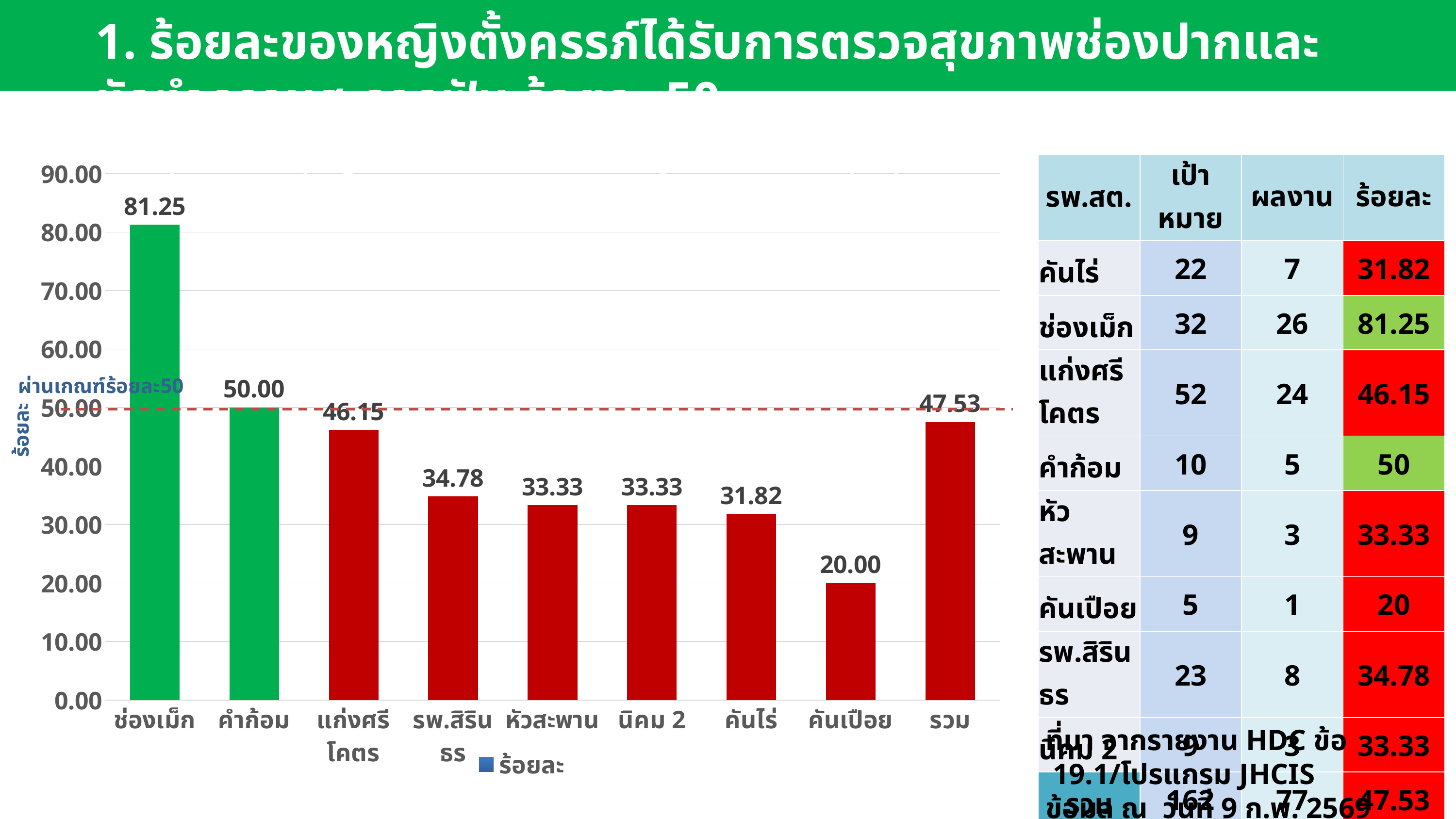
Which category has the highest value? ช่องเม็ก What is the difference between the values for ช่องเม็ก and คำก้อม? 31.25 Which is larger, the value for รพ.สิรินธร or the value for คันไร่? รพ.สิรินธร What is the value for แก่งศรีโคตร? 46.15 What is the legend entry for the plotted series? ร้อยละ What is the value for คันเปือย? 20.00 Which category has the lowest value? คันเปือย What kind of chart is shown? bar chart How many categories are shown on the x axis? 9 What is the value for รวม? 47.53 Is the value for รวม greater or less than 50? less What is the value for ช่องเม็ก? 81.25